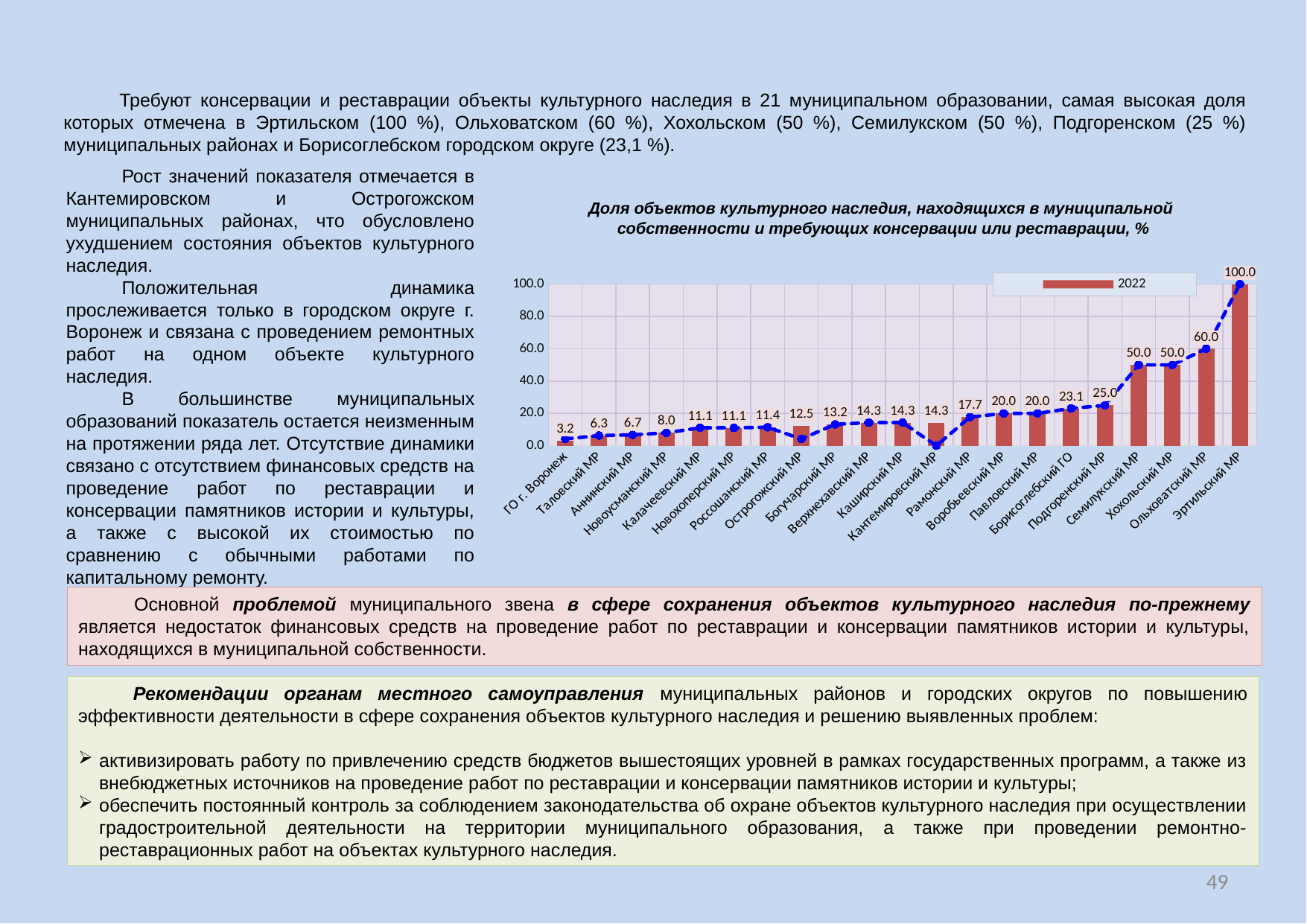
What is the value for Рамонский МР in 2022? 17.7 How many series does the legend list? 1 Do the 2022 values rise or fall from left to right along the x axis? rise What is the difference between the 2022 values for Ольховатский МР and Подгоренский МР? 35.0 Which has the larger 2022 value, Семилукский МР or Богучарский МР? Семилукский МР What is the value for ГО г. Воронеж in 2022? 3.2 What kind of chart is this? combination bar and line chart Which category has the highest 2022 value? Эртильский МР How many categories are shown on the x axis? 21 What is the value for Эртильский МР in 2022? 100.0 What is the value for Борисоглебский ГО in 2022? 23.1 Which category has the lowest 2022 value? ГО г. Воронеж